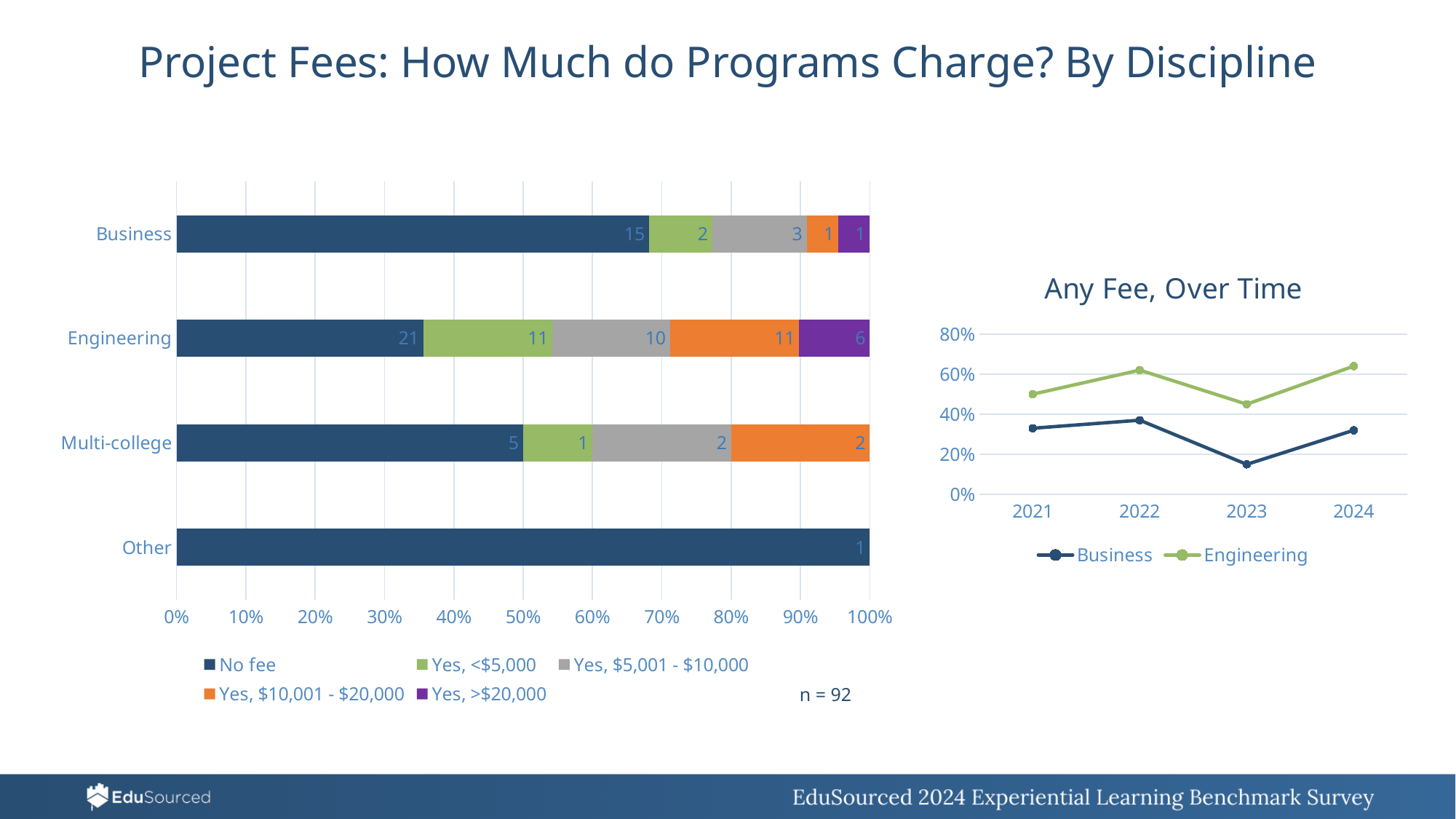
In the left stacked bar chart, what is the 'Yes, $5,001 - $10,000' count for Business? 3 In the left stacked bar chart, what is the 'Yes, $10,001 - $20,000' count for Multi-college? 2 In the 'Any Fee, Over Time' chart, is the Engineering value for 2024 greater or less than 60%? greater In the left stacked bar chart, what is the difference between the 'No fee' counts for Engineering and Business? 6 In the left stacked bar chart, what is the total count across all segments for the Business bar? 22 In the 'Any Fee, Over Time' chart, is the Business value for 2023 greater or less than 20%? less In the left stacked bar chart, what is the 'No fee' count for Engineering? 21 What type of chart is 'Any Fee, Over Time'? Line chart How many series does the legend of the left stacked bar chart list? 5 In the left stacked bar chart, which discipline has the highest 'Yes, >$20,000' count? Engineering In the left stacked bar chart, what is the total count across all segments for the Engineering bar? 59 In the 'Any Fee, Over Time' chart, which series is higher in 2022, Business or Engineering? Engineering